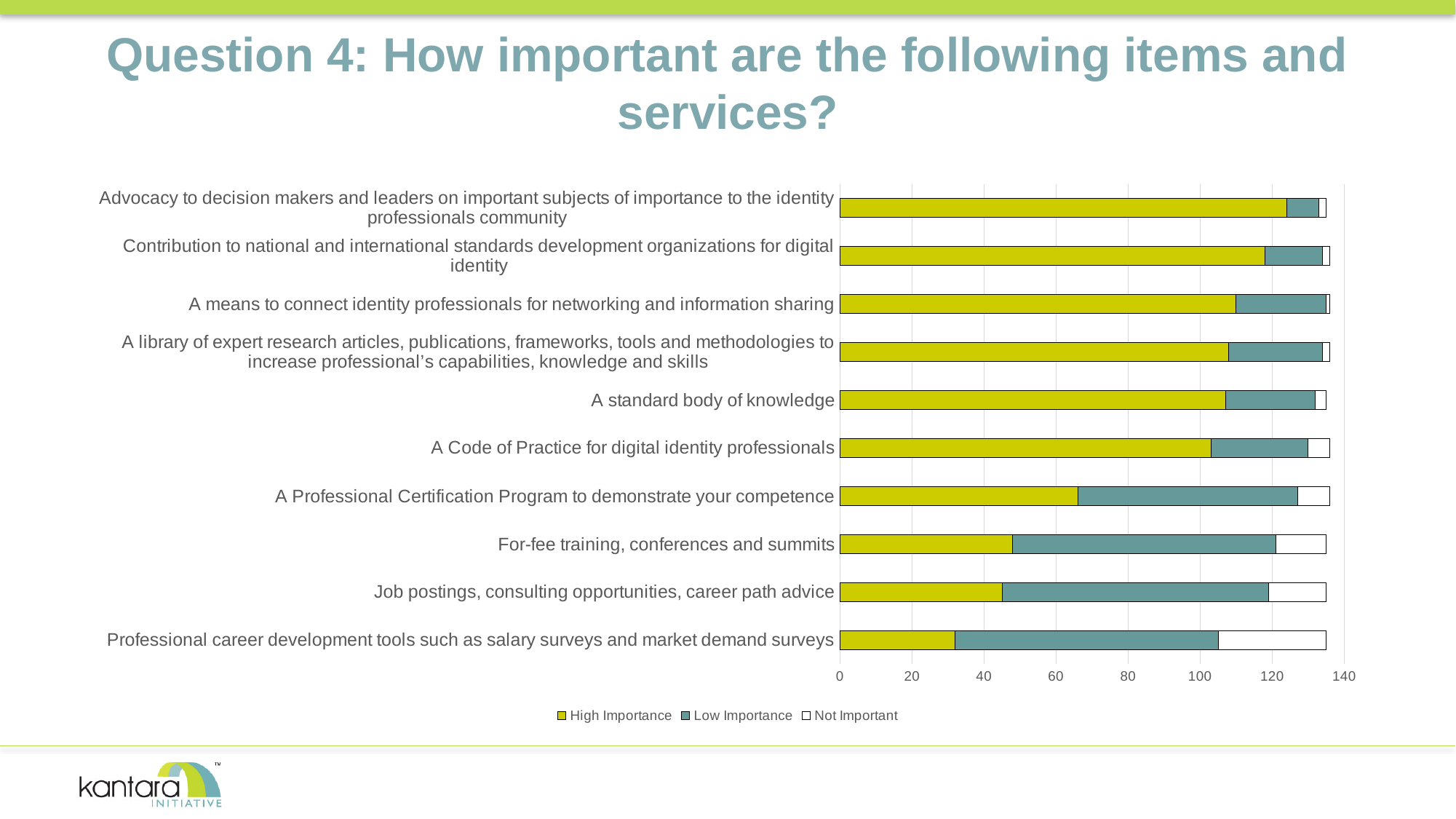
Is the High Importance value for 'Professional career development tools such as salary surveys and market demand surveys' greater or less than 40? less What are the three legend entries of the chart? High Importance, Low Importance, Not Important How many items or services are listed as categories in the chart? 10 What kind of chart is shown on the slide? Stacked bar chart Which has the larger Low Importance value: 'Job postings, consulting opportunities, career path advice' or 'A standard body of knowledge'? Job postings, consulting opportunities, career path advice How many series does the legend list? 3 Which category has the lowest High Importance value? Professional career development tools such as salary surveys and market demand surveys Is the High Importance value for 'For-fee training, conferences and summits' greater or less than 60? less Which category has the highest High Importance value? Advocacy to decision makers and leaders on important subjects of importance to the identity professionals community Is the High Importance value for 'Advocacy to decision makers and leaders on important subjects of importance to the identity professionals community' greater or less than 100? greater Which category has the highest Not Important value? Professional career development tools such as salary surveys and market demand surveys